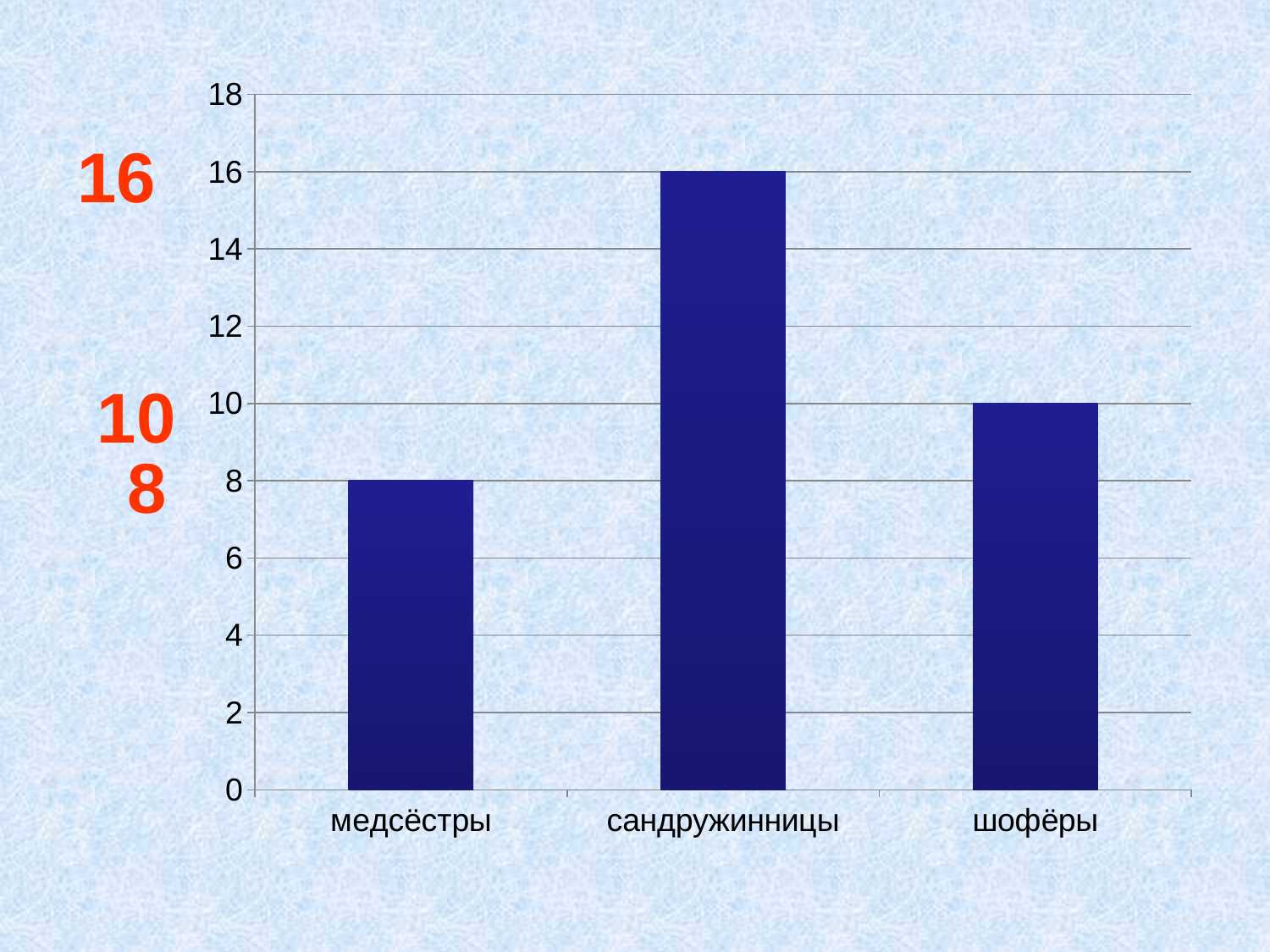
What is the value for сандружинницы? 16 What kind of chart is shown on the slide? bar chart Is the value for сандружинницы greater or less than 12? greater Which is larger, the value for шофёры or the value for медсёстры? шофёры How many categories are shown on the x axis of the chart? 3 Which category has the highest value? сандружинницы What is the value for шофёры? 10 What is the highest value shown on the vertical axis of the chart? 18 What is the difference between the values for сандружинницы and медсёстры? 8 What is the value for медсёстры? 8 Which category has the lowest value? медсёстры What is the difference between the values for шофёры and медсёстры? 2